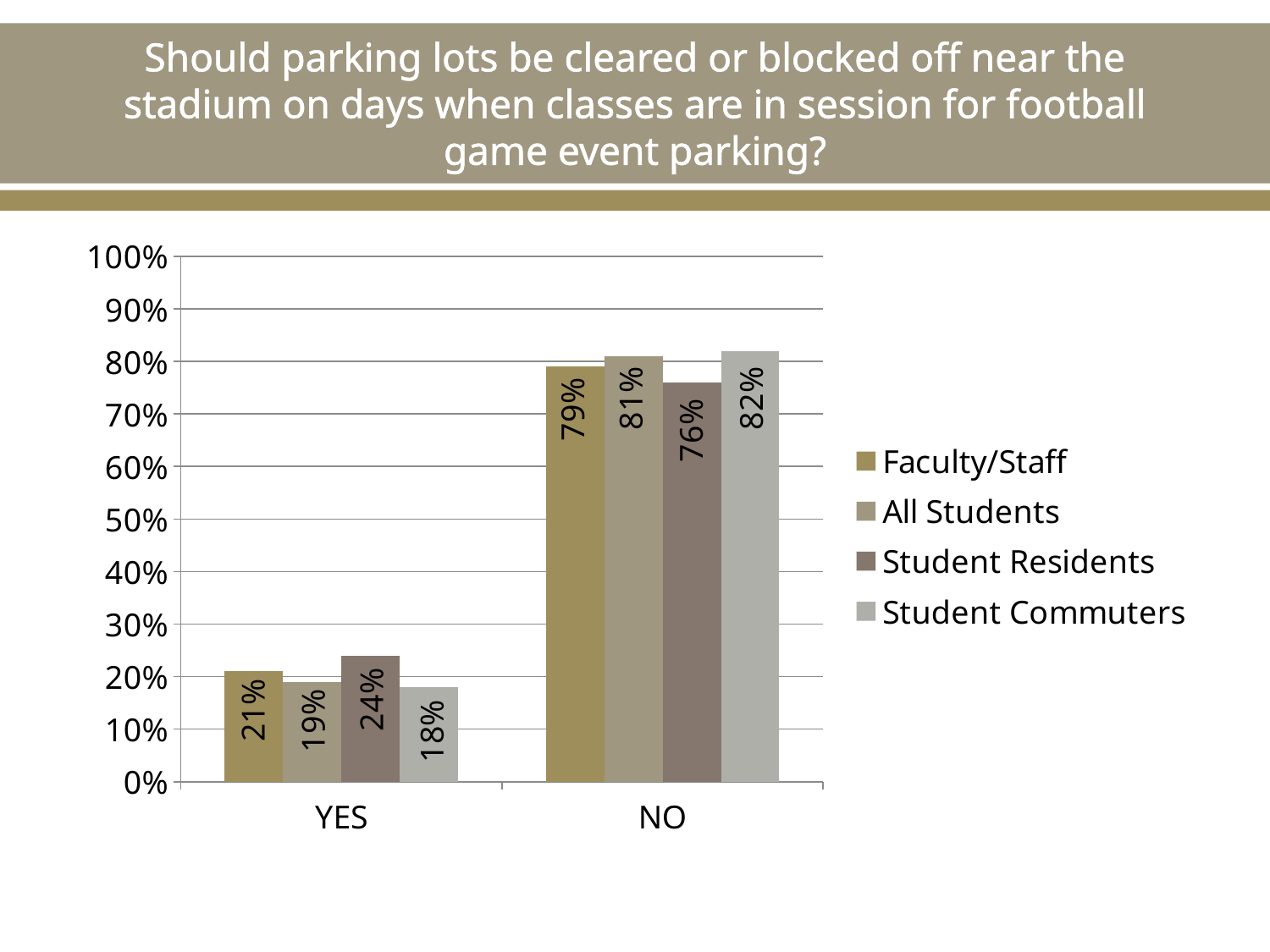
What percentage of Student Commuters answered NO? 82% Which legend entry is shown in the darkest brown colour? Student Residents Which group has the highest percentage answering YES? Student Residents What percentage of Student Residents answered YES? 24% What kind of chart is shown on the slide? Bar chart Which is larger: the YES percentage for Faculty/Staff or for All Students? Faculty/Staff What percentage of All Students answered NO? 81% How many series does the legend list? 4 What percentage of Faculty/Staff answered YES? 21% Which group has the lowest percentage answering NO? Student Residents How many answer categories are shown on the x axis? 2 What is the difference between the NO percentages for Student Commuters and Student Residents? 6%